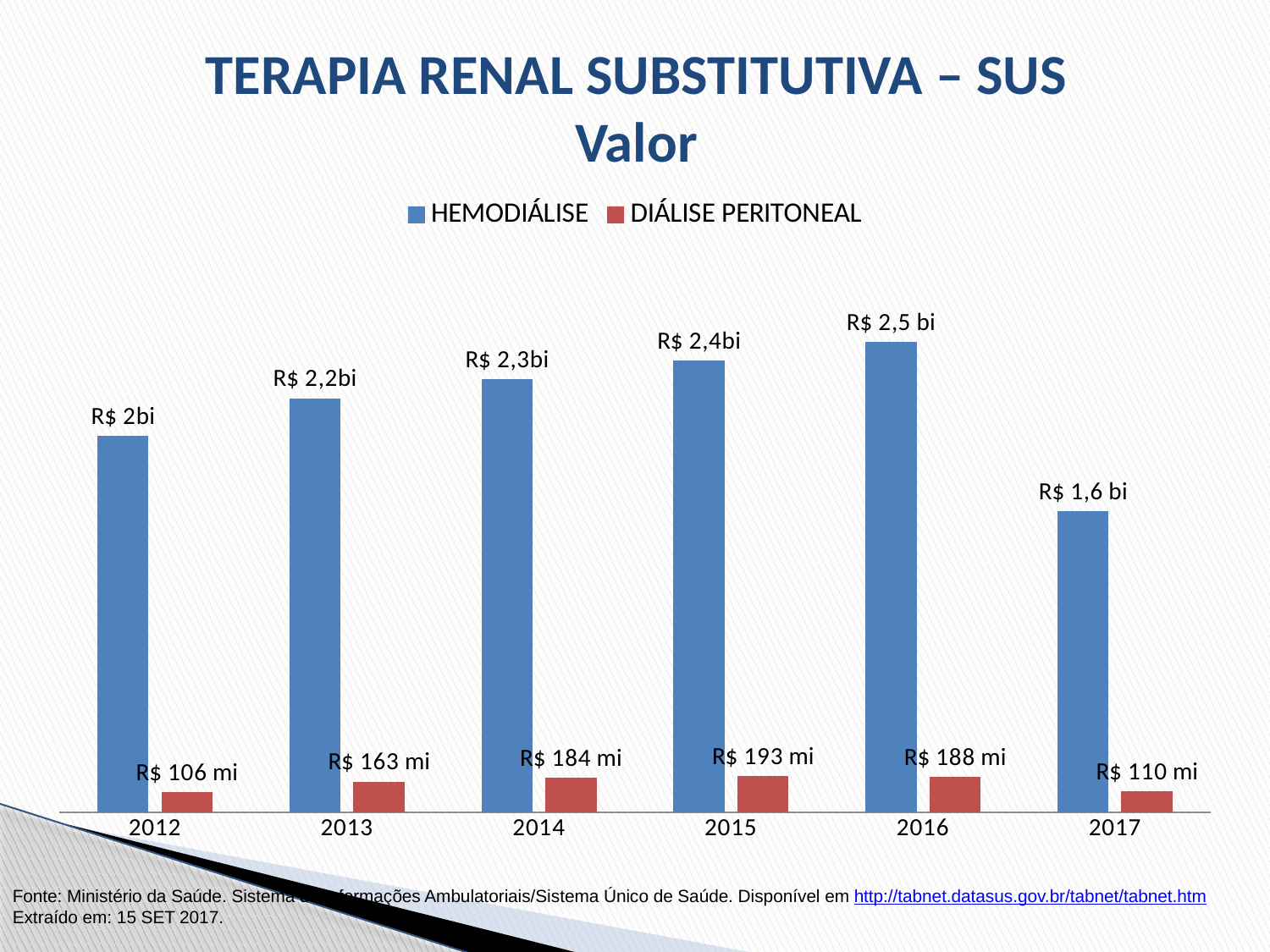
How many years are shown on the x axis? 6 What is the value for HEMODIÁLISE in 2017? R$ 1,6 bi Which is larger, the DIÁLISE PERITONEAL value for 2013 or for 2017? 2013 In which year is the DIÁLISE PERITONEAL value lowest? 2012 How many series does the legend list? 2 In which year is the HEMODIÁLISE value highest? 2016 What is the value for HEMODIÁLISE in 2014? R$ 2,3bi What is the difference between the HEMODIÁLISE values for 2016 and 2012? R$ 0,5 bi What is the value for DIÁLISE PERITONEAL in 2012? R$ 106 mi What is the difference between the DIÁLISE PERITONEAL values for 2015 and 2014? R$ 9 mi What is the value for DIÁLISE PERITONEAL in 2015? R$ 193 mi What kind of chart is shown on the slide? Bar chart